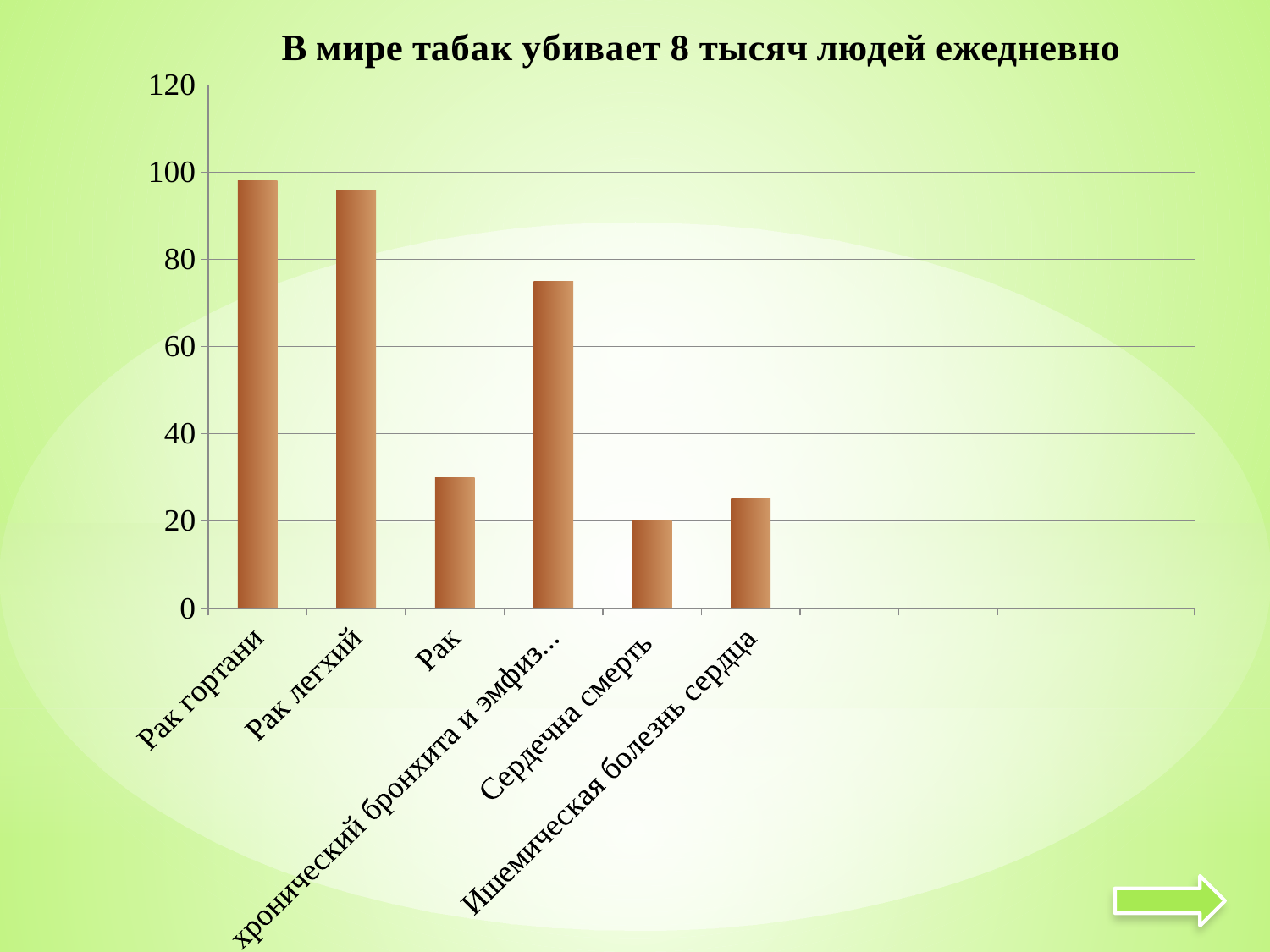
What is the title of the chart? В мире табак убивает 8 тысяч людей ежедневно What kind of chart is shown on the slide? bar chart How many categories are plotted in the chart? 6 Which is larger, the value for Рак легкий or the value for хронический бронхита и эмфиз...? Рак легхий Is the value for Ишемическая болезнь сердца greater or less than 40? less Is the value for Рак гортани greater or less than 80? greater Is the value for хронический бронхита и эмфиз... greater or less than 60? greater Which is larger, the value for Рак or the value for Ишемическая болезнь сердца? Рак Which category has the lowest bar? Сердечна смерть What is the highest value shown on the vertical axis? 120